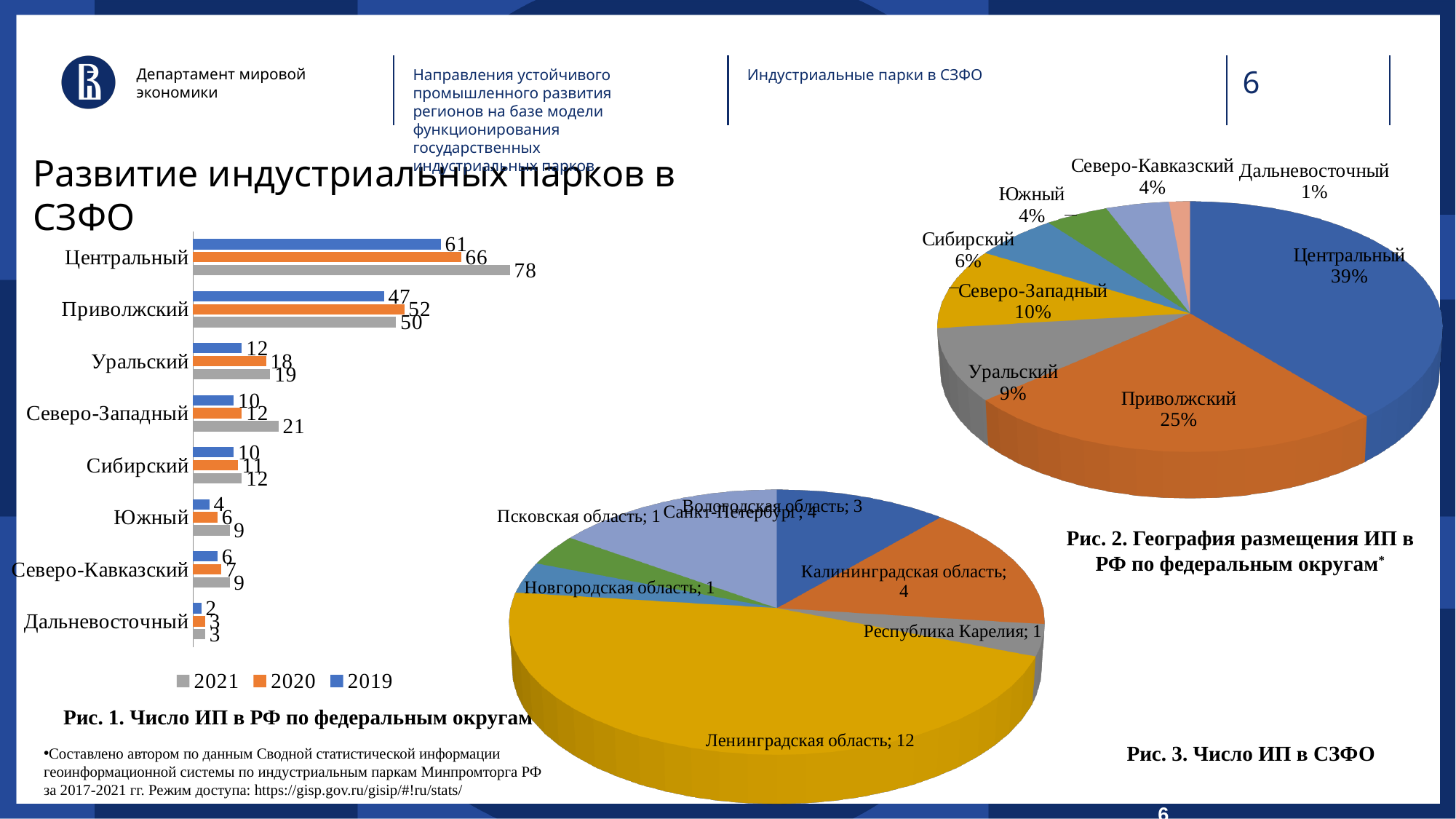
In the chart 'Рис. 1. Число ИП в РФ по федеральным округам', which is larger for Приволжский: the 2020 value or the 2021 value? 2020 In the chart 'Рис. 1. Число ИП в РФ по федеральным округам', what is the value for Северо-Западный in 2019? 10 In the chart 'Рис. 2. География размещения ИП в РФ по федеральным округам', how many federal districts are shown? 8 In the chart 'Рис. 2. География размещения ИП в РФ по федеральным округам', which federal district has the largest share? Центральный In the chart 'Рис. 3. Число ИП в СЗФО', what is the difference between Калининградская область and Вологодская область? 1 In the chart 'Рис. 1. Число ИП в РФ по федеральным округам', what is the value for Центральный in 2021? 78 In the chart 'Рис. 3. Число ИП в СЗФО', what is the value for Ленинградская область? 12 In the chart 'Рис. 1. Число ИП в РФ по федеральным округам', how many series does the legend list? 3 In the chart 'Рис. 1. Число ИП в РФ по федеральным округам', which federal district has the lowest value in 2021? Дальневосточный In the chart 'Рис. 2. География размещения ИП в РФ по федеральным округам', what share does Приволжский have? 25% What kind of chart is 'Рис. 1. Число ИП в РФ по федеральным округам'? Bar chart In the chart 'Рис. 1. Число ИП в РФ по федеральным округам', what is the difference between the 2021 and 2019 values for Северо-Западный? 11